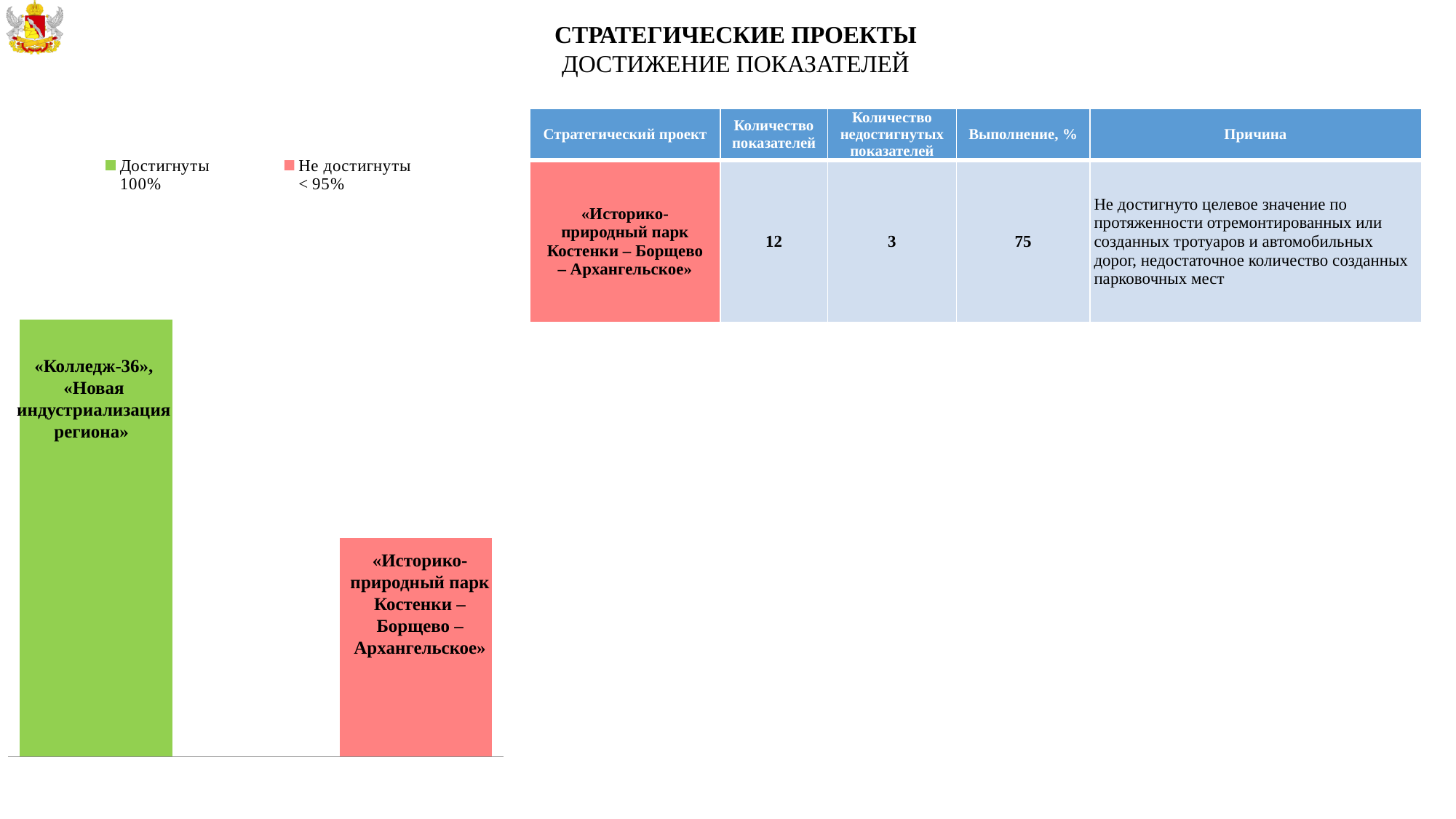
What legend entry corresponds to the green colour in the bar chart? Достигнуты 100% Which bar in the chart is the lowest? «Историко-природный парк Костенки – Борщево – Архангельское» Which bar in the chart is taller: the green bar for «Колледж-36», «Новая индустриализация региона» or the red bar for «Историко-природный парк Костенки – Борщево – Архангельское»? «Колледж-36», «Новая индустриализация региона» How many series does the legend of the bar chart list? 2 Which bar in the chart is the highest? «Колледж-36», «Новая индустриализация региона» What kind of chart is shown on the left of the slide? Bar chart How many bars are plotted in the bar chart? 2 What legend entry corresponds to the red colour in the bar chart? Не достигнуты < 95%